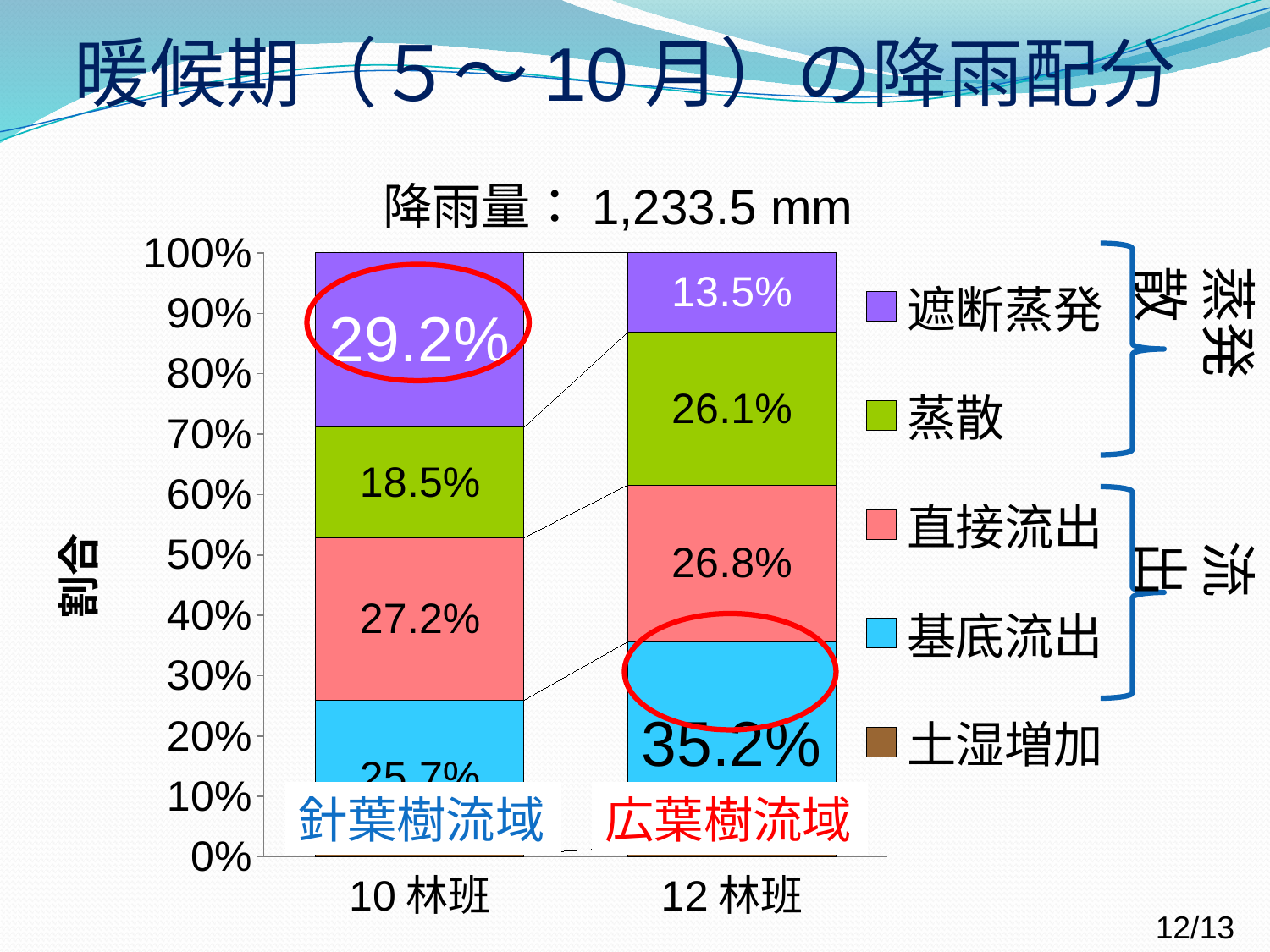
How many series does the legend list? 5 What is the value of 蒸散 for 12林班? 26.1% What kind of chart is shown on the slide? stacked bar chart What rainfall amount is stated above the chart? 1,233.5 mm What is the difference between the 遮断蒸発 values for 10林班 and 12林班? 15.7% Which category has the larger 蒸散 value, 10林班 or 12林班? 12林班 What is the value of 基底流出 for 12林班? 35.2% What is the value of 遮断蒸発 for 12林班? 13.5% What is the value of 遮断蒸発 for 10林班? 29.2% Which series has the largest value in the 12林班 bar? 基底流出 What is the value of 直接流出 for 10林班? 27.2% How many categories are plotted on the x axis? 2